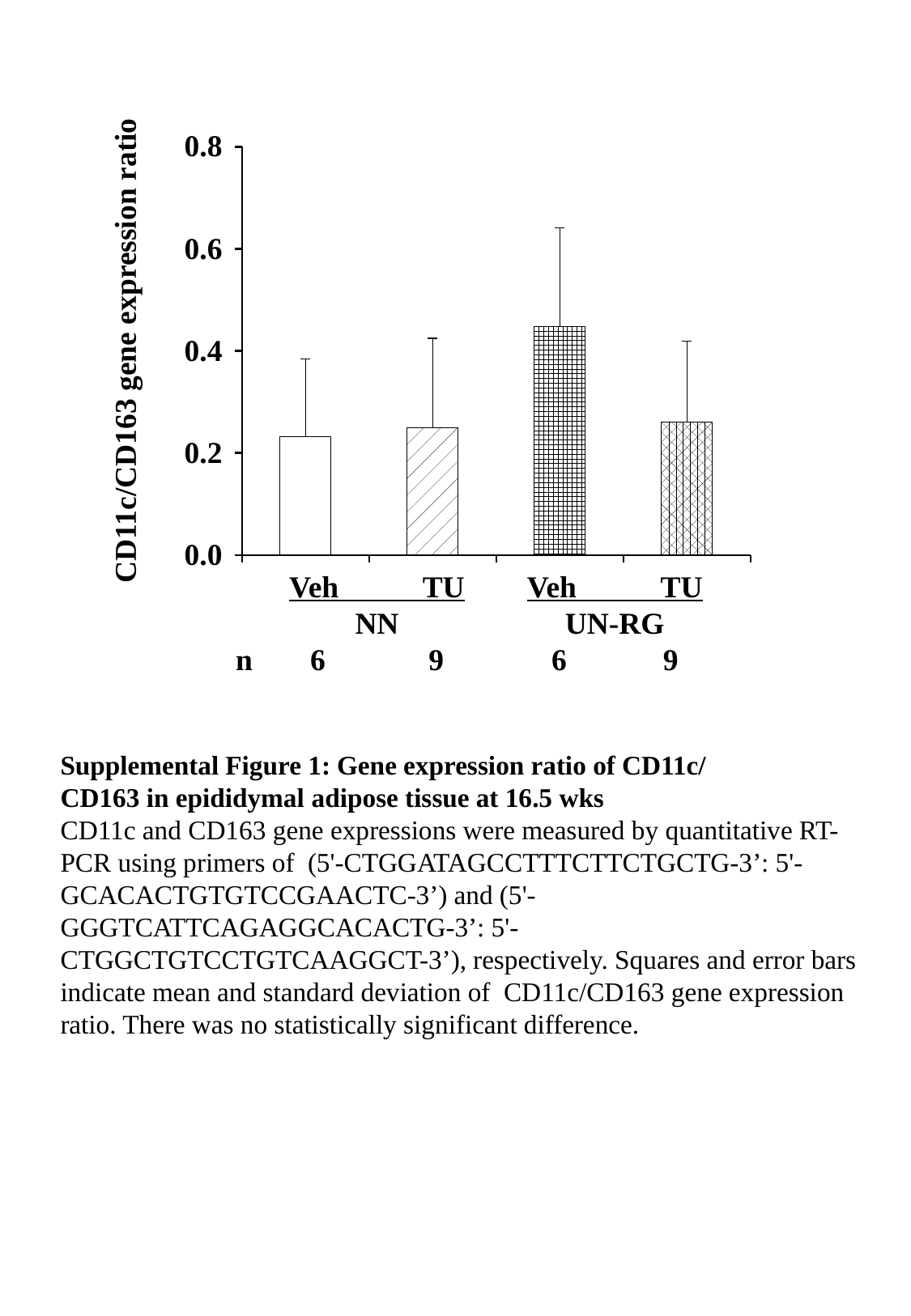
What kind of chart is shown on the slide? bar chart What is the n value shown for the NN TU group? 9 Is the value for NN Veh greater or less than 0.2? greater How many bars are plotted in the chart? 4 What is the label of the y axis? CD11c/CD163 gene expression ratio Is the value for UN-RG Veh greater or less than 0.6? less Which is larger, the value for UN-RG Veh or the value for UN-RG TU? UN-RG Veh Is the value for UN-RG Veh greater or less than 0.4? greater Which is larger, the value for UN-RG Veh or the value for NN Veh? UN-RG Veh Which group has the highest CD11c/CD163 gene expression ratio? UN-RG Veh